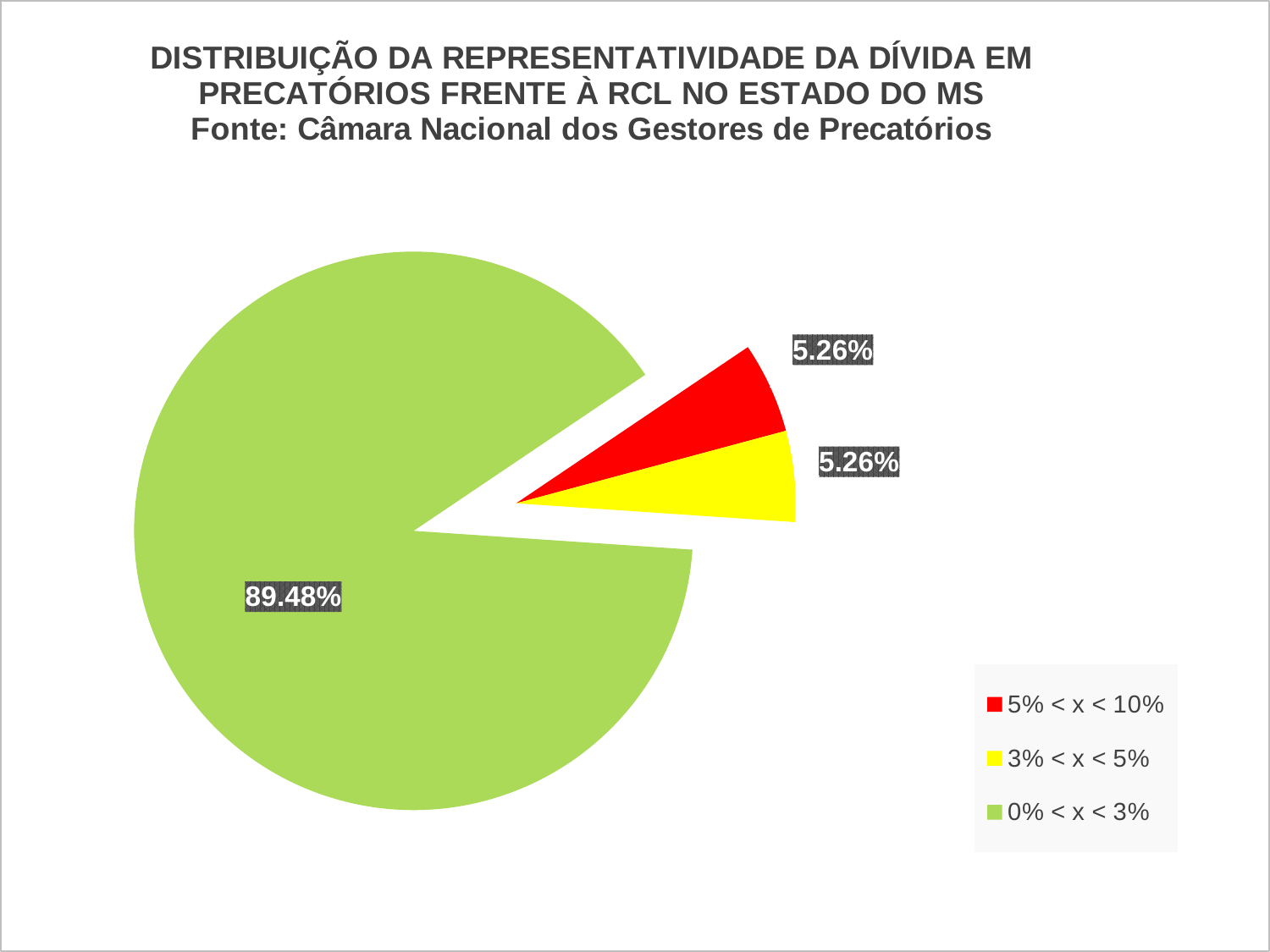
How many slices does the pie chart have? 3 Is the "0% < x < 3%" slice larger than the "3% < x < 5%" slice? Yes What share of the pie does the "0% < x < 3%" slice represent? 89.48% What is the difference between the "0% < x < 3%" slice and the "5% < x < 10%" slice? 84.22% How many entries does the legend list? 3 Which category has the largest slice of the pie? 0% < x < 3% What share of the pie does the "5% < x < 10%" slice represent? 5.26% What colour is the "5% < x < 10%" slice? Red What colour is the "3% < x < 5%" slice? Yellow What is the combined share of the "5% < x < 10%" and "3% < x < 5%" slices? 10.52% What share of the pie does the "3% < x < 5%" slice represent? 5.26% What kind of chart is shown on the slide? Pie chart